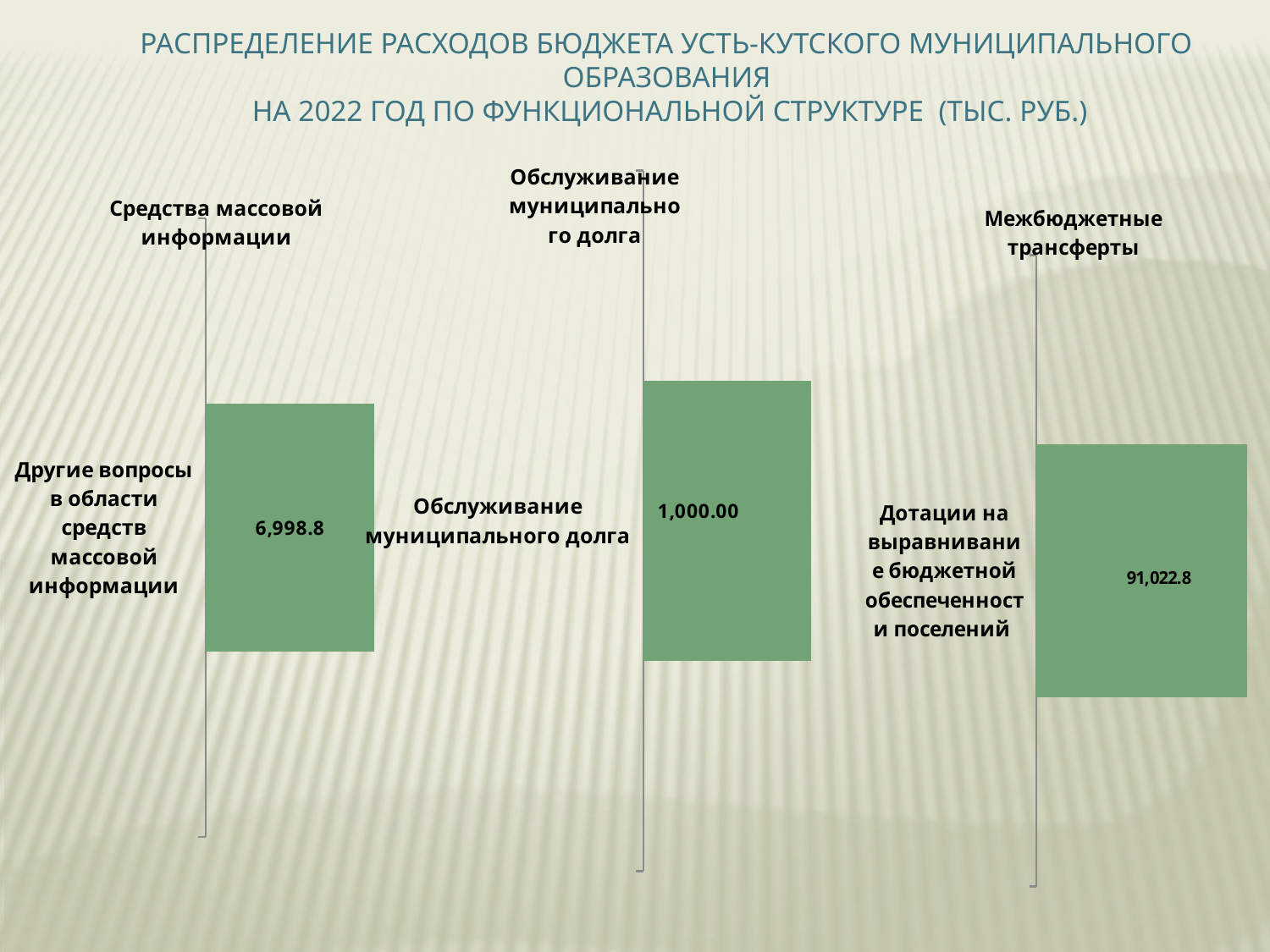
What is the title of the chart on the right side of the slide? Межбюджетные трансферты How many charts are shown on the slide? 3 In the chart titled "Межбюджетные трансферты", what is the value for "Дотации на выравнивание бюджетной обеспеченности поселений"? 91,022.8 What is the difference between the value in the chart titled "Средства массовой информации" (6,998.8) and the value in the chart titled "Обслуживание муниципального долга" (1,000.00)? 5,998.8 Which is larger: the value in the chart titled "Межбюджетные трансферты" (91,022.8) or the value in the chart titled "Средства массовой информации" (6,998.8)? Межбюджетные трансферты (91,022.8) What is the difference between the value in the chart titled "Межбюджетные трансферты" (91,022.8) and the value in the chart titled "Средства массовой информации" (6,998.8)? 84,024.0 In the chart titled "Средства массовой информации", what is the value for "Другие вопросы в области средств массовой информации"? 6,998.8 In the chart titled "Обслуживание муниципального долга", what is the value for "Обслуживание муниципального долга"? 1,000.00 What kind of chart is the chart titled "Средства массовой информации"? bar chart Across the three charts on the slide, which chart shows the smallest printed value? Обслуживание муниципального долга Across the three charts on the slide, which chart shows the largest printed value? Межбюджетные трансферты How many bars does the chart titled "Межбюджетные трансферты" contain? 1